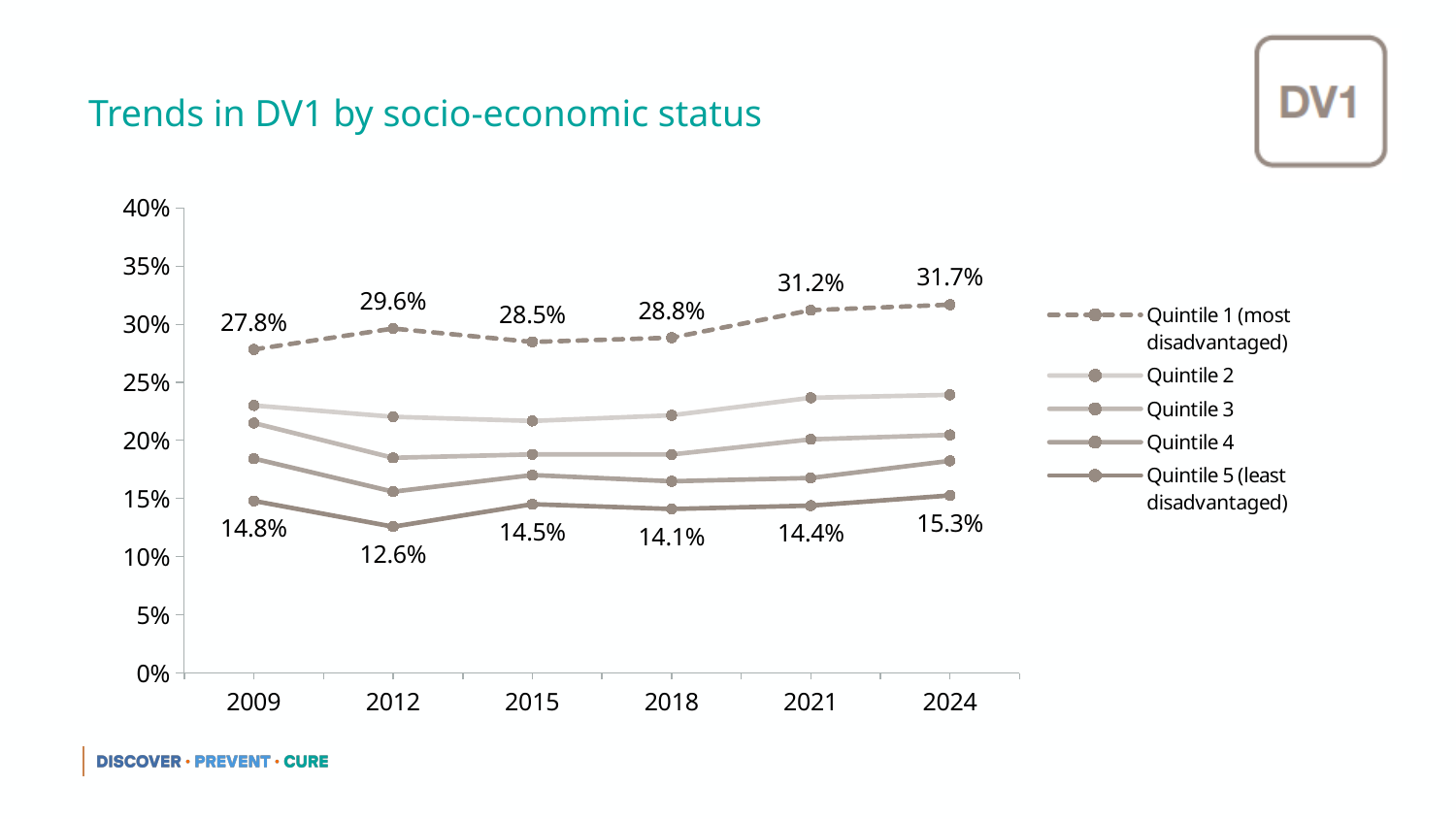
What is the value for Quintile 1 (most disadvantaged) in 2024? 31.7% What is the difference between the Quintile 1 and Quintile 5 values in 2009? 13 percentage points How many series does the legend list? 5 What kind of chart is shown on the slide? line chart What is the value for Quintile 5 (least disadvantaged) in 2018? 14.1% How many years are shown on the x axis? 6 In which year is the value for Quintile 1 (most disadvantaged) highest? 2024 What is the value for Quintile 1 (most disadvantaged) in 2012? 29.6% Is the value for Quintile 2 in 2024 greater or less than 20%? greater Does the value for Quintile 1 (most disadvantaged) rise or fall between 2018 and 2024? rise Which series has the higher value in 2021, Quintile 1 (most disadvantaged) or Quintile 5 (least disadvantaged)? Quintile 1 (most disadvantaged) In which year is the value for Quintile 5 (least disadvantaged) lowest? 2012